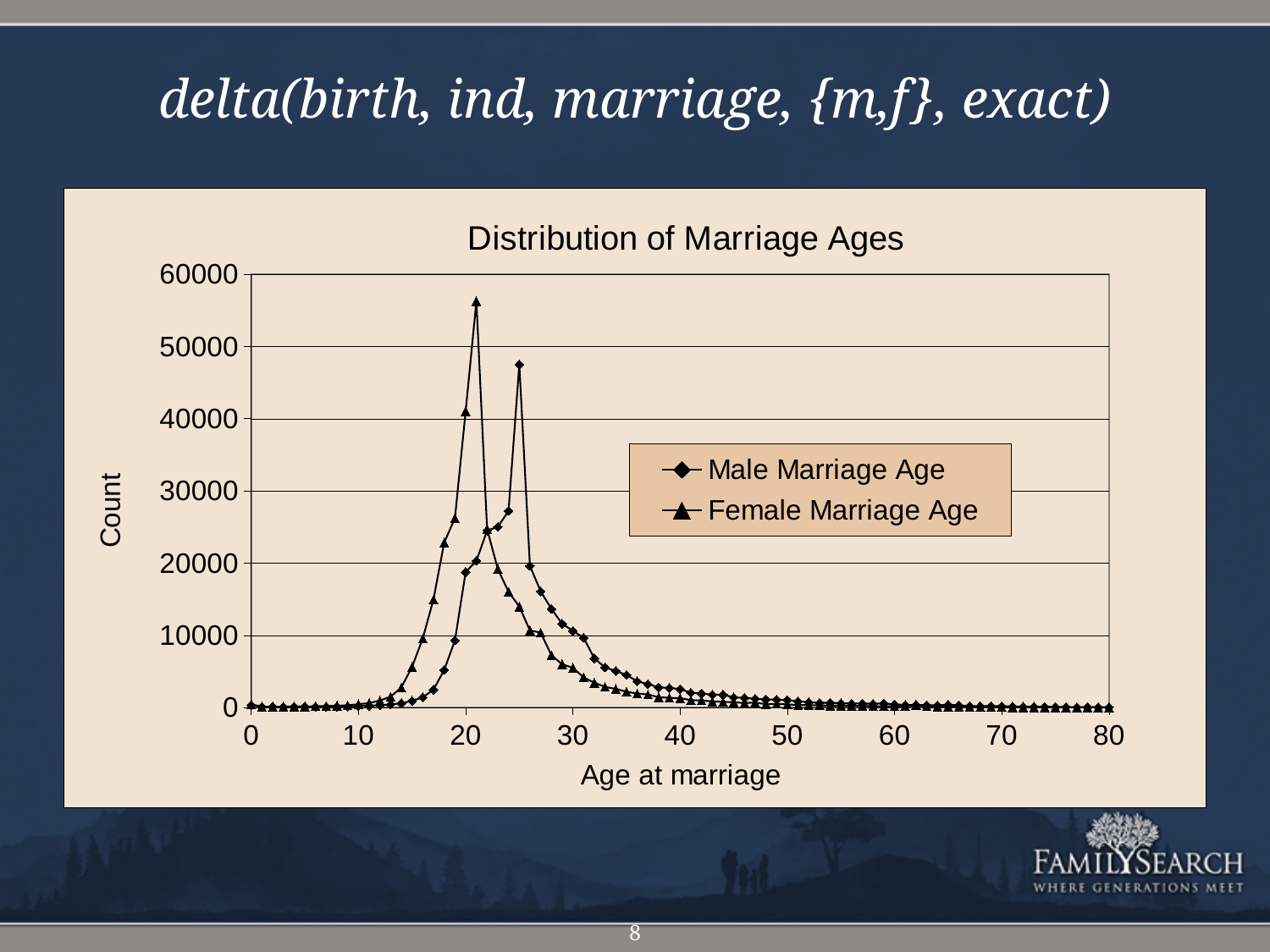
Is the peak value of the Male Marriage Age series greater or less than 40000? greater At age 25, which series has the higher count, Male Marriage Age or Female Marriage Age? Male Marriage Age What kind of chart is shown on the slide? line chart What is the label of the x axis? Age at marriage Is the Male Marriage Age count at age 40 greater or less than 10000? less What is the title of the chart? Distribution of Marriage Ages How many series does the legend list? 2 Is the peak value of the Male Marriage Age series greater or less than 50000? less Which series reaches the higher peak count, Male Marriage Age or Female Marriage Age? Female Marriage Age From age 30 to age 80, do the counts for the Male Marriage Age series rise or fall? fall At age 21, which series has the higher count, Male Marriage Age or Female Marriage Age? Female Marriage Age